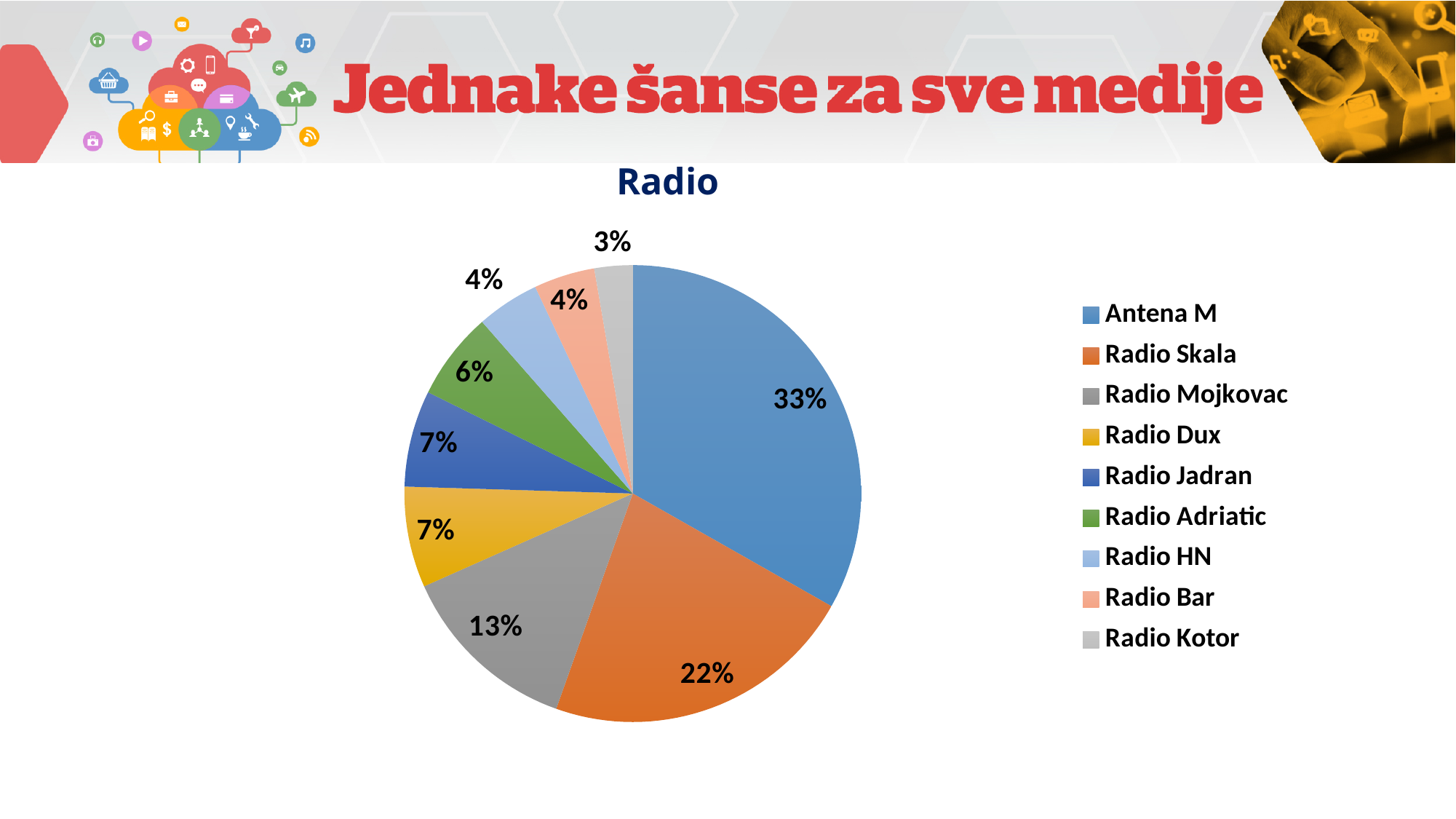
What is the combined share of Radio HN and Radio Bar? 8% Which radio station has the smallest slice of the pie? Radio Kotor Which is larger, the share for Radio Mojkovac or the share for Radio Dux? Radio Mojkovac What share of the pie does Antena M hold? 33% What is the difference between the shares of Antena M and Radio Skala? 11% What type of chart is shown on the slide? Pie chart What is the value shown for Radio Mojkovac? 13% What is the title of the chart? Radio How many radio stations are shown in the pie chart? 9 What is the value shown for Radio Skala? 22% Which radio station has the largest slice of the pie? Antena M What is the value shown for Radio Adriatic? 6%